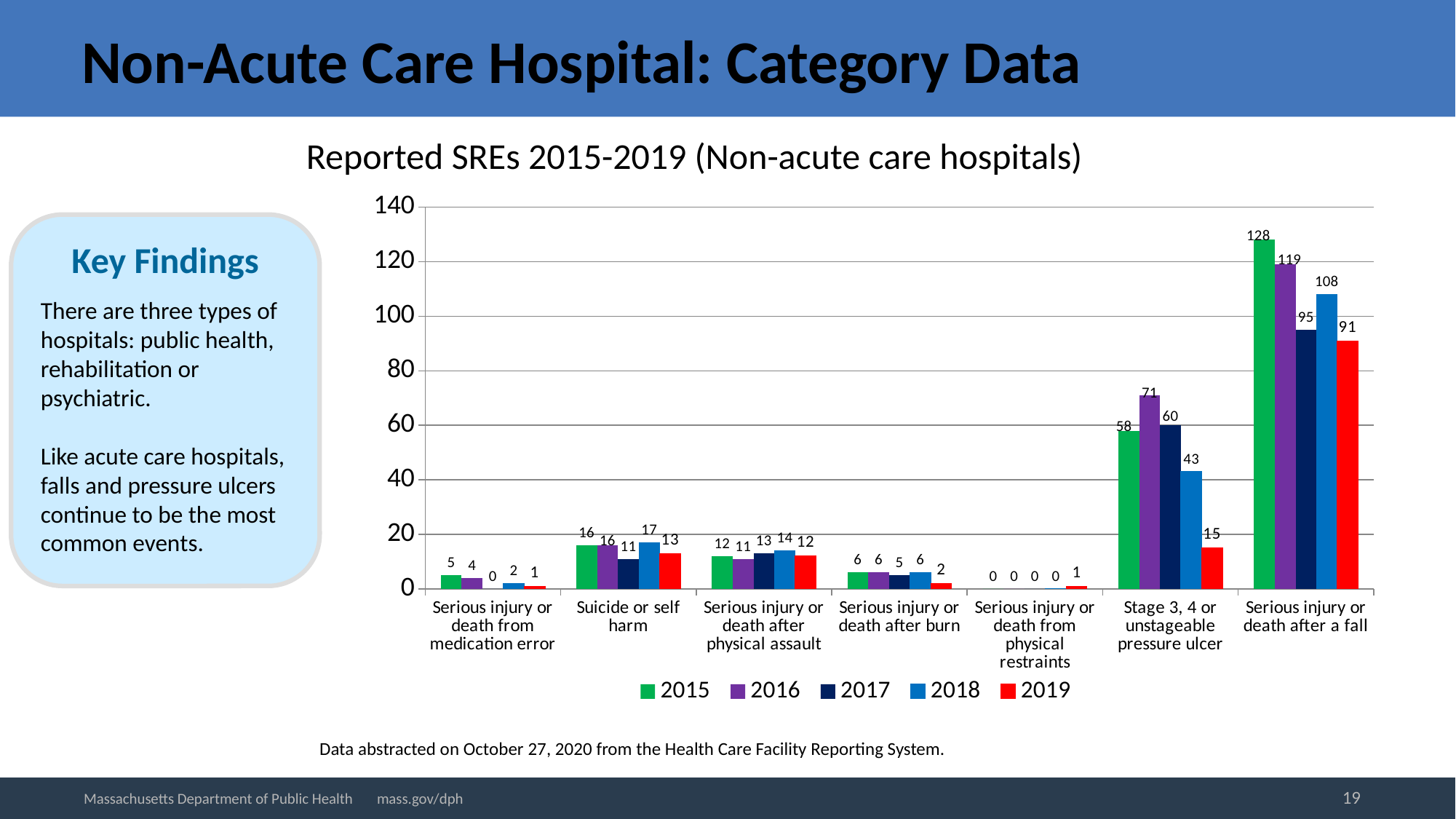
What kind of chart is shown on the slide? Bar chart What is the title of the chart? Reported SREs 2015-2019 (Non-acute care hospitals) Which is larger: the 2017 value or the 2018 value for 'Serious injury or death after a fall'? 2018 What is the value for 2015 in the 'Serious injury or death after a fall' category? 128 Do the values for 'Stage 3, 4 or unstageable pressure ulcer' rise or fall from 2016 to 2019? Fall How many series does the legend list? 5 Which year has the lowest value in the 'Serious injury or death after a fall' category? 2019 Which year has the highest value in the 'Stage 3, 4 or unstageable pressure ulcer' category? 2016 What is the value for 2019 in the 'Suicide or self harm' category? 13 How many categories are shown on the x axis? 7 What is the value for 2018 in the 'Stage 3, 4 or unstageable pressure ulcer' category? 43 What is the difference between the 2015 and 2019 values in the 'Serious injury or death after a fall' category? 37